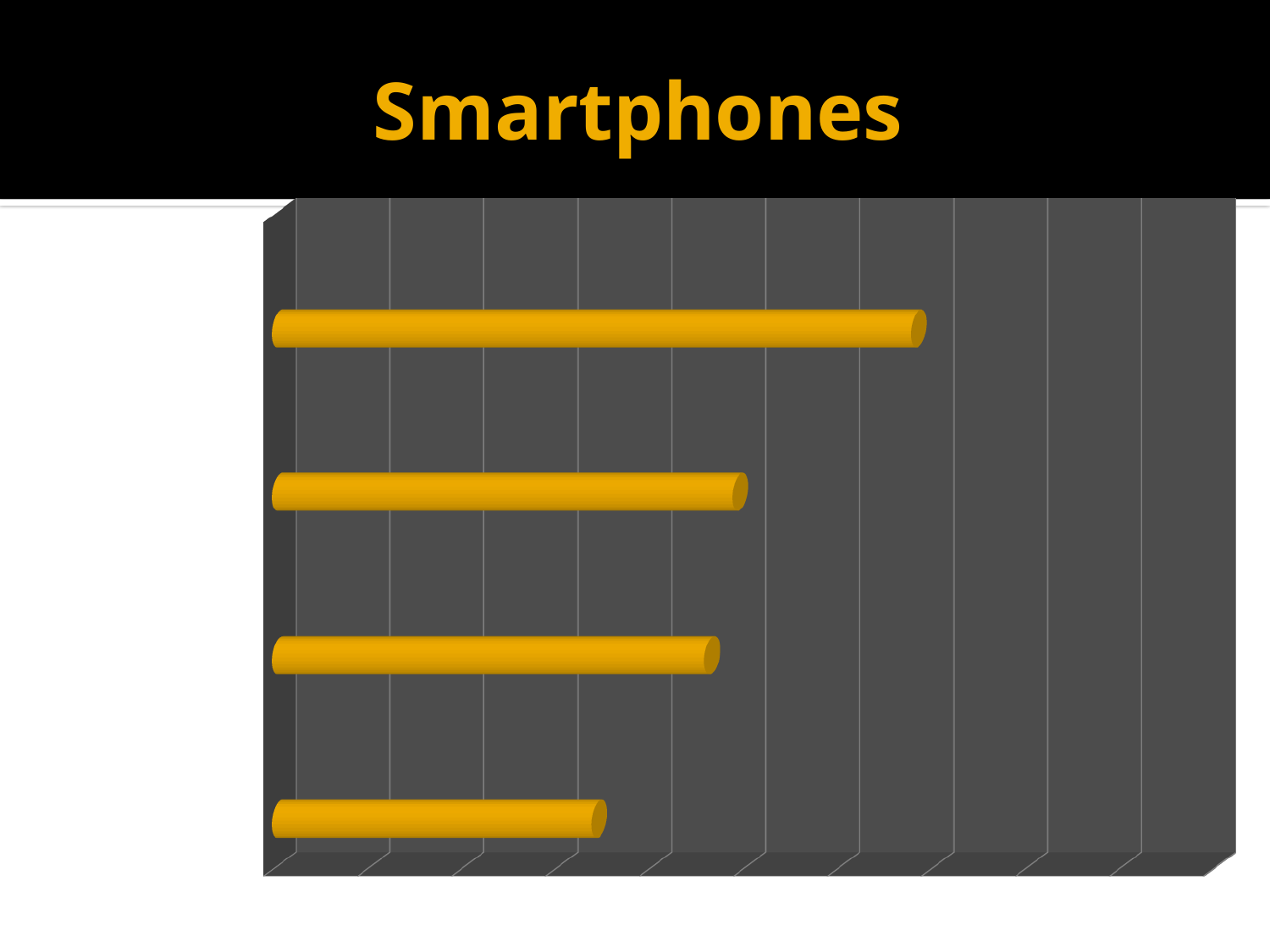
What kind of chart is shown on the slide? bar chart What is the title shown above the chart? Smartphones Which bar is the shortest: the top, second, third or bottom bar? the bottom bar Which is longer, the second bar from the top or the bottom bar? the second bar from the top Are the bars in the chart horizontal or vertical? horizontal Which bar is the longest: the top, second, third or bottom bar? the top bar What colour are the bars in the chart? orange Do the bar lengths generally increase or decrease going from the top bar to the bottom bar? decrease Which is longer, the third bar from the top or the bottom bar? the third bar from the top How many bars are plotted in the chart? 4 Which is longer, the top bar or the second bar from the top? the top bar